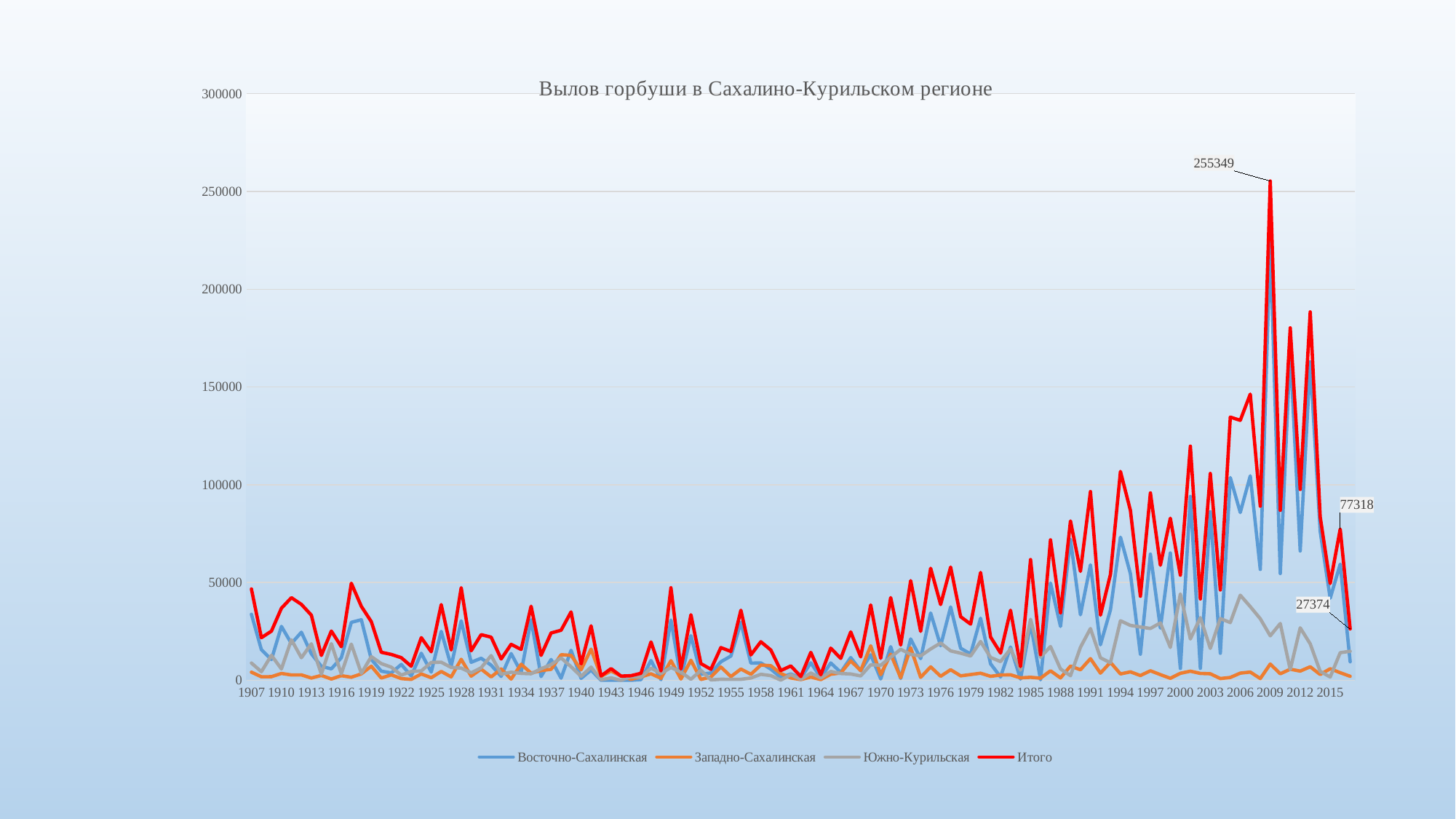
Is the value of Итого in 2009 greater or less than 250000? greater How many series does the legend list? 4 Which series is drawn in red? Итого What kind of chart is shown on the slide? line chart What is the title of the chart? Вылов горбуши в Сахалино-Курильском регионе In which year does the Итого line reach its peak? 2009 What is the difference between the labeled peak value 255349 and the labeled final value 27374 on the Итого line? 227975 Does the Итого line generally rise or fall from 1907 to 2009? rise What is the highest labeled value on the Итого line? 255349 What is the difference between the labeled values 255349 and 77318 on the Итого line? 178031 What is the value labeled at the last point of the Итого line? 27374 In 2009, which series has the larger value: Восточно-Сахалинская or Западно-Сахалинская? Восточно-Сахалинская